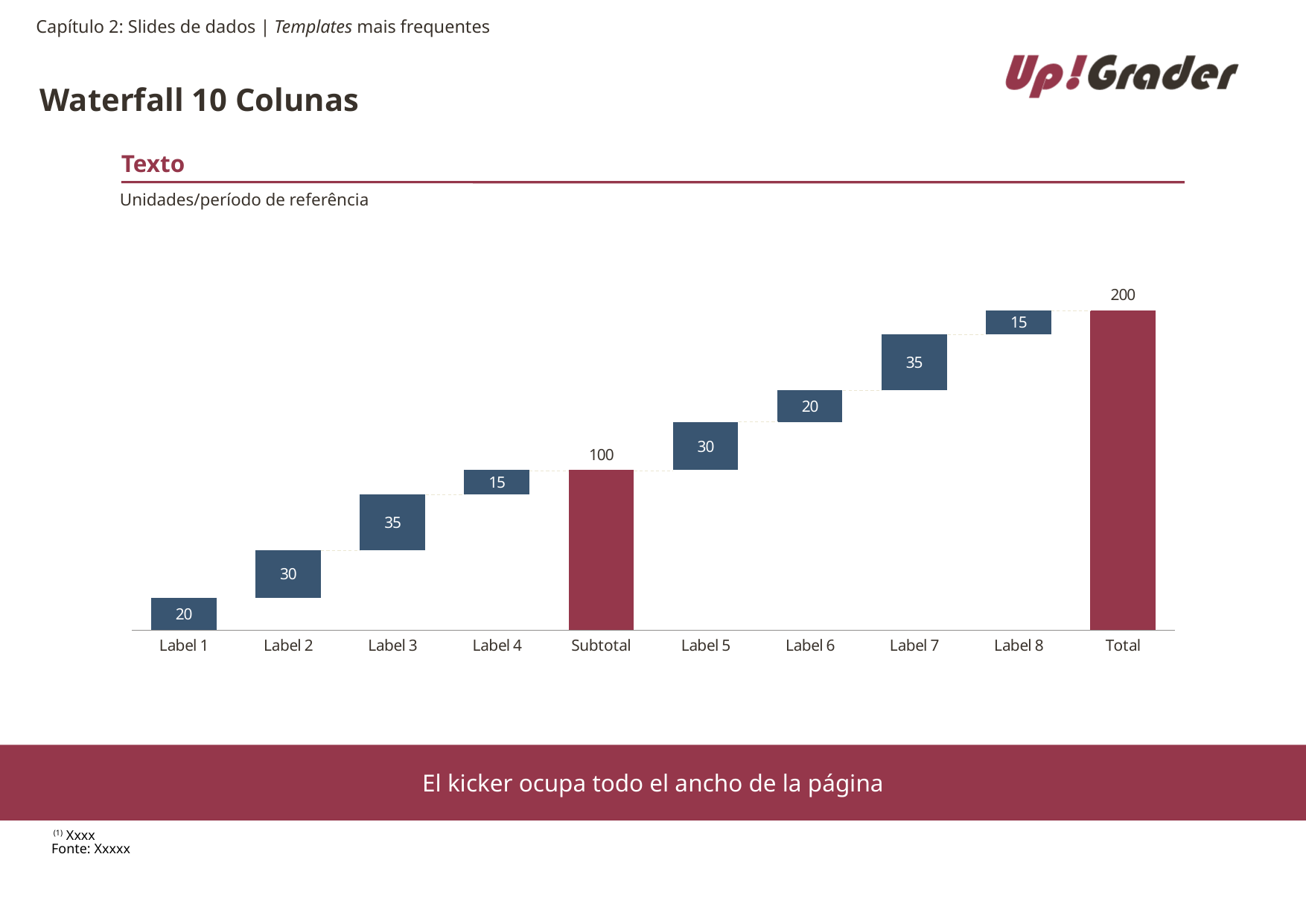
Which is larger, the value for Label 2 or the value for Label 4? Label 2 What is the sum of the values for Label 5, Label 6, Label 7 and Label 8? 100 How many columns are plotted in the chart? 10 What is the value shown for Label 3? 35 What is the value of the Total bar? 200 Which column has the highest value in the chart? Total What is the difference between the Total value and the Subtotal value? 100 What is the value shown for Label 6? 20 What is the title shown above the chart? Texto What value is printed above the Subtotal bar? 100 Among Label 1 to Label 4, which has the lowest value? Label 4 What kind of chart is shown on the slide? Waterfall chart